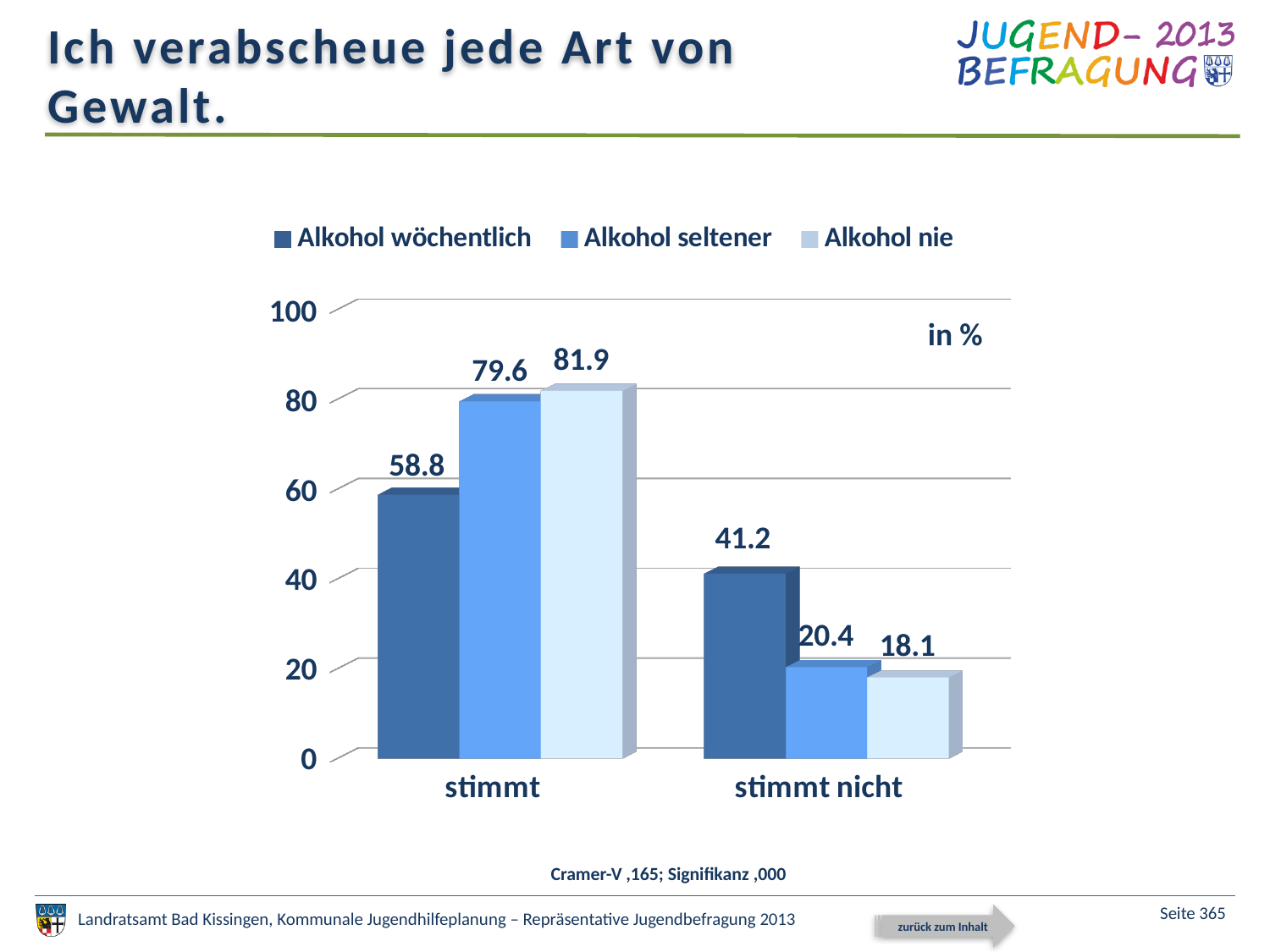
Which series has the highest value in the 'stimmt' category? Alkohol nie What is the value for 'Alkohol wöchentlich' in the 'stimmt' category? 58.8 How many series does the legend list? 3 What is the value for 'Alkohol nie' in the 'stimmt nicht' category? 18.1 Which series has the lowest value in the 'stimmt nicht' category? Alkohol nie Is the value for 'Alkohol nie' in the 'stimmt' category greater or less than 80? greater Which is larger: 'Alkohol wöchentlich' for 'stimmt' or 'Alkohol wöchentlich' for 'stimmt nicht'? stimmt What kind of chart is shown on the slide? bar chart What unit is indicated in the chart area? in % What is the difference between 'Alkohol wöchentlich' and 'Alkohol seltener' in the 'stimmt nicht' category? 20.8 How many categories are shown on the x axis? 2 What is the value for 'Alkohol seltener' in the 'stimmt' category? 79.6